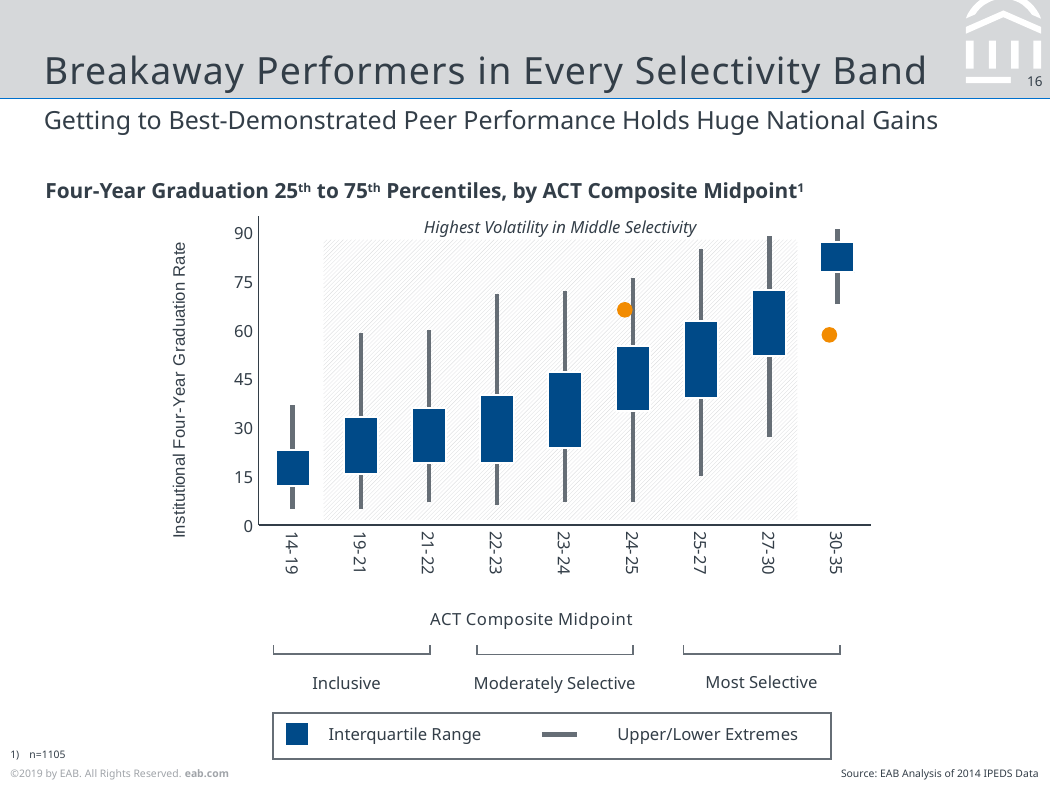
Is the upper extreme for the 25-27 band greater or less than 75? greater Is the lower extreme for the 14-19 band greater or less than 15? less Is the top of the interquartile range box for the 14-19 band greater or less than 30? less Which ACT Composite Midpoint band has the lowest interquartile range box? 14-19 Which ACT Composite Midpoint band has the highest interquartile range box? 30-35 Do the interquartile range boxes generally rise or fall as the ACT Composite Midpoint increases along the x axis? Rise What kind of chart is shown on the slide? Box-and-whisker plot How many ACT Composite Midpoint categories are plotted on the x axis? 9 How many entries does the legend list? 2 What is the label on the y axis of the chart? Institutional Four-Year Graduation Rate Which band has a higher top of its interquartile range box, 25-27 or 27-30? 27-30